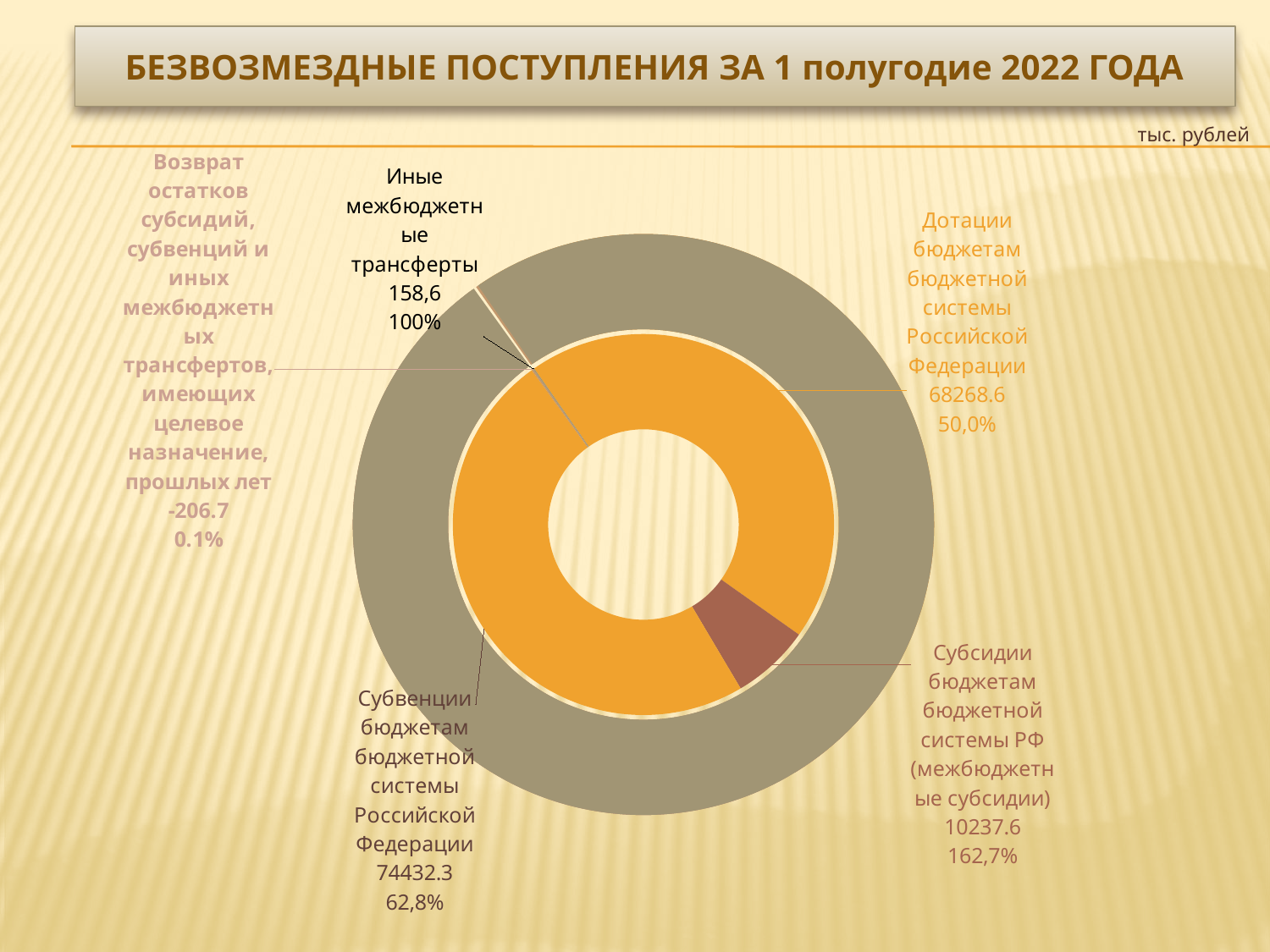
What kind of chart is shown on the slide? Doughnut (pie) chart What is the value shown for Дотации бюджетам бюджетной системы Российской Федерации? 68268.6 What is the difference between the values for Субвенции бюджетам бюджетной системы Российской Федерации and Дотации бюджетам бюджетной системы Российской Федерации? 6163.7 Which is larger: the value for Дотации бюджетам бюджетной системы Российской Федерации or the value for Субсидии бюджетам бюджетной системы РФ (межбюджетные субсидии)? Дотации бюджетам бюджетной системы Российской Федерации What is the value shown for Возврат остатков субсидий, субвенций и иных межбюджетных трансфертов, имеющих целевое назначение, прошлых лет? -206.7 Which category has the lowest value on the chart? Возврат остатков субсидий, субвенций и иных межбюджетных трансфертов, имеющих целевое назначение, прошлых лет Which category has the highest value on the chart? Субвенции бюджетам бюджетной системы Российской Федерации What is the value shown for Субвенции бюджетам бюджетной системы Российской Федерации? 74432.3 What is the value shown for Иные межбюджетные трансферты? 158,6 What percentage is printed next to Субсидии бюджетам бюджетной системы РФ (межбюджетные субсидии)? 162,7% What is the value shown for Субсидии бюджетам бюджетной системы РФ (межбюджетные субсидии)? 10237.6 How many categories are shown on the chart? 5